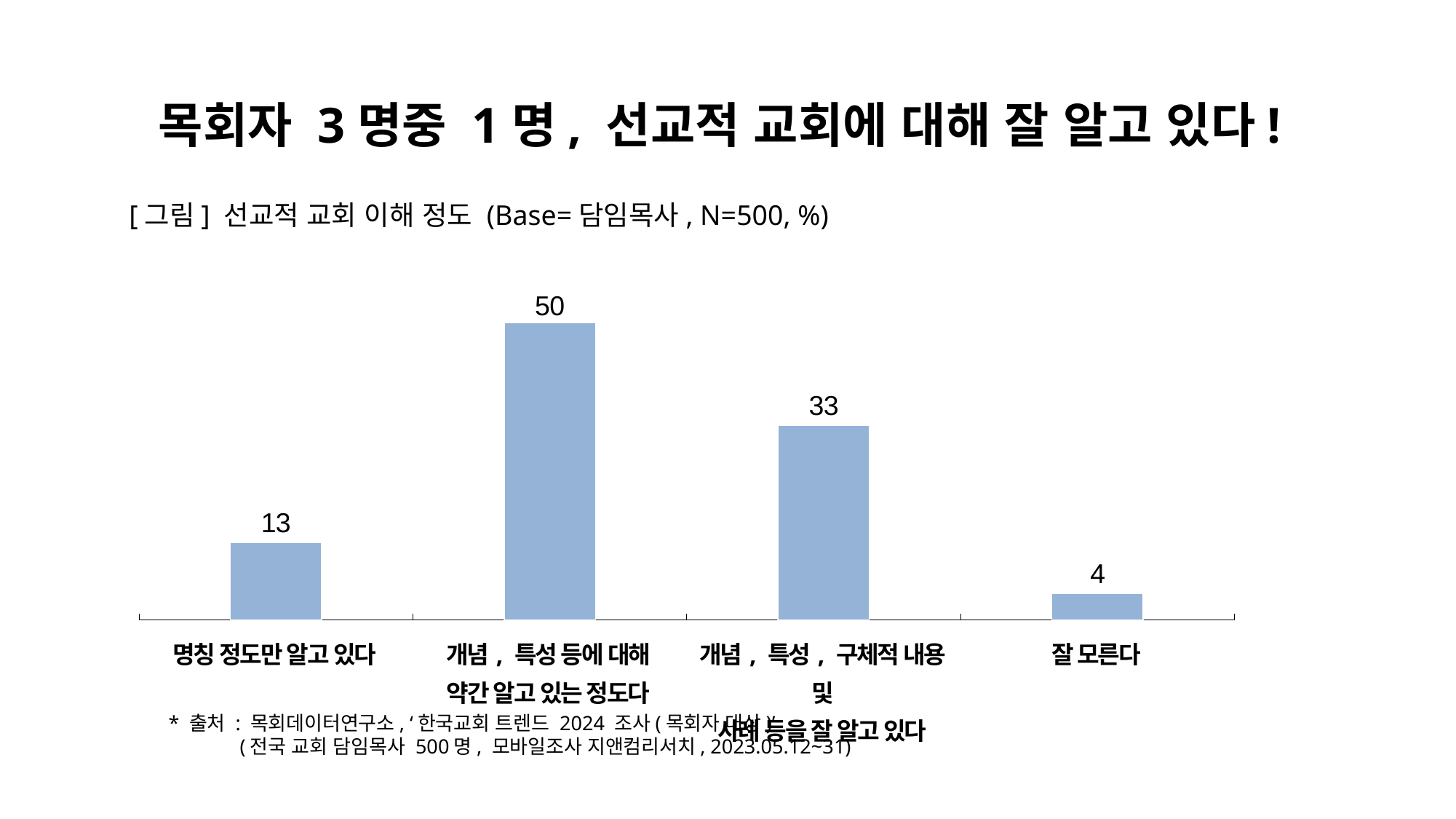
What is the value for '명칭 정도만 알고 있다'? 13 Which is larger: the value for '명칭 정도만 알고 있다' or the value for '잘 모른다'? 명칭 정도만 알고 있다 What is the value for '잘 모른다'? 4 What is the base (N) stated in the chart caption? N=500 Which category has the lowest value? 잘 모른다 What kind of chart is shown on the slide? Bar chart Which category has the highest value? 개념, 특성 등에 대해 약간 알고 있는 정도다 What is the difference between the values for '개념, 특성 등에 대해 약간 알고 있는 정도다' and '명칭 정도만 알고 있다'? 37 How many categories are shown in the chart? 4 What is the difference between the values for '개념, 특성 등에 대해 약간 알고 있는 정도다' and '잘 모른다'? 46 What colour are the bars in the chart? Light blue What is the value for '개념, 특성 등에 대해 약간 알고 있는 정도다'? 50